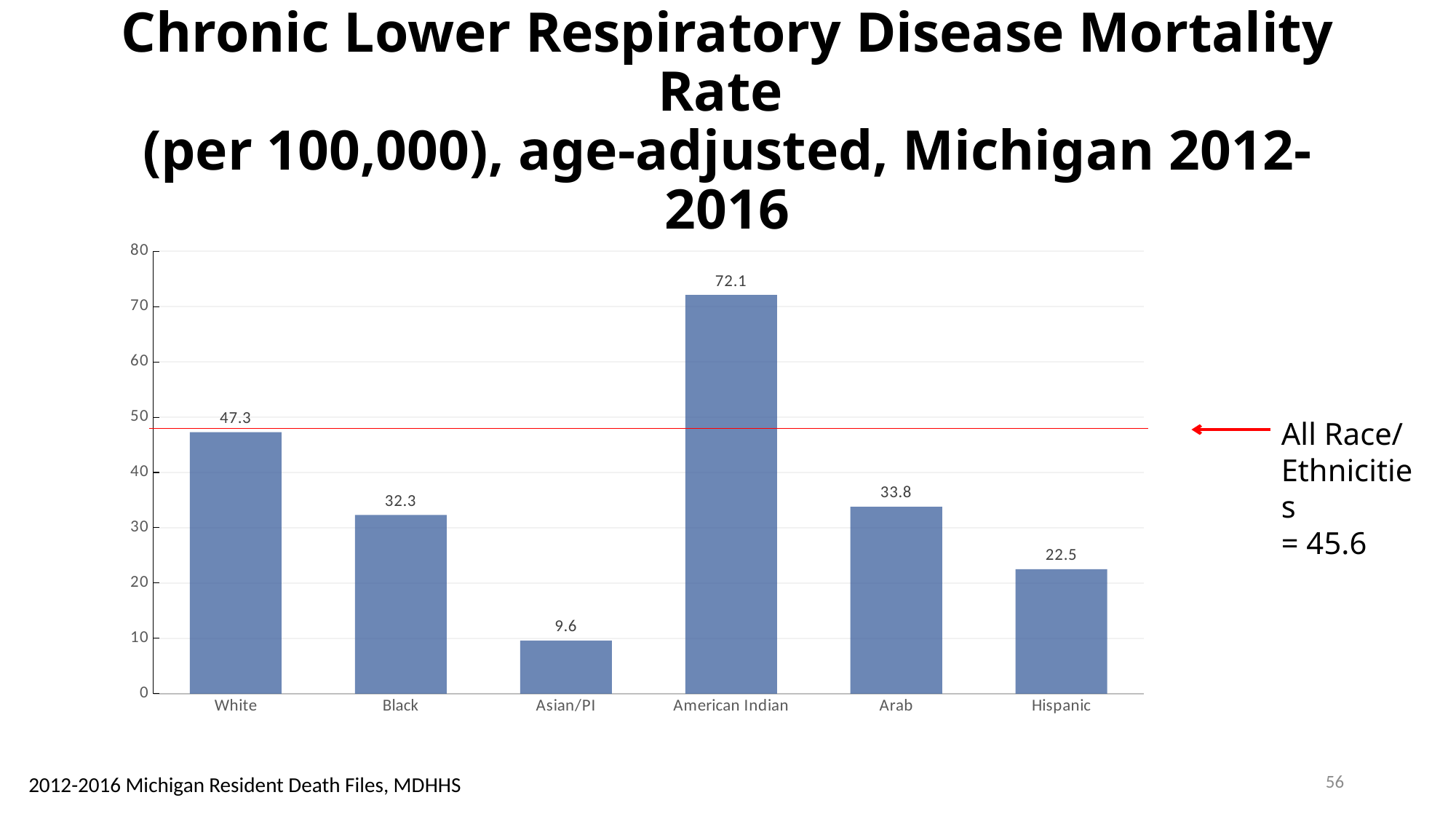
What type of chart is shown on the slide? Bar chart What is the mortality rate shown for Asian/PI residents? 9.6 Which race/ethnicity group has the highest mortality rate? American Indian What is the mortality rate shown for Hispanic residents? 22.5 What is the mortality rate for all race/ethnicities indicated by the red line? 45.6 How many race/ethnicity groups are shown in the chart? 6 What is the difference between the mortality rates for American Indian and White residents? 24.8 Which group has a higher mortality rate, Black or Hispanic? Black What is the difference between the mortality rates for Arab and Black residents? 1.5 Which race/ethnicity group has the lowest mortality rate? Asian/PI What is the chronic lower respiratory disease mortality rate for White residents? 47.3 What is the mortality rate shown for American Indian residents? 72.1